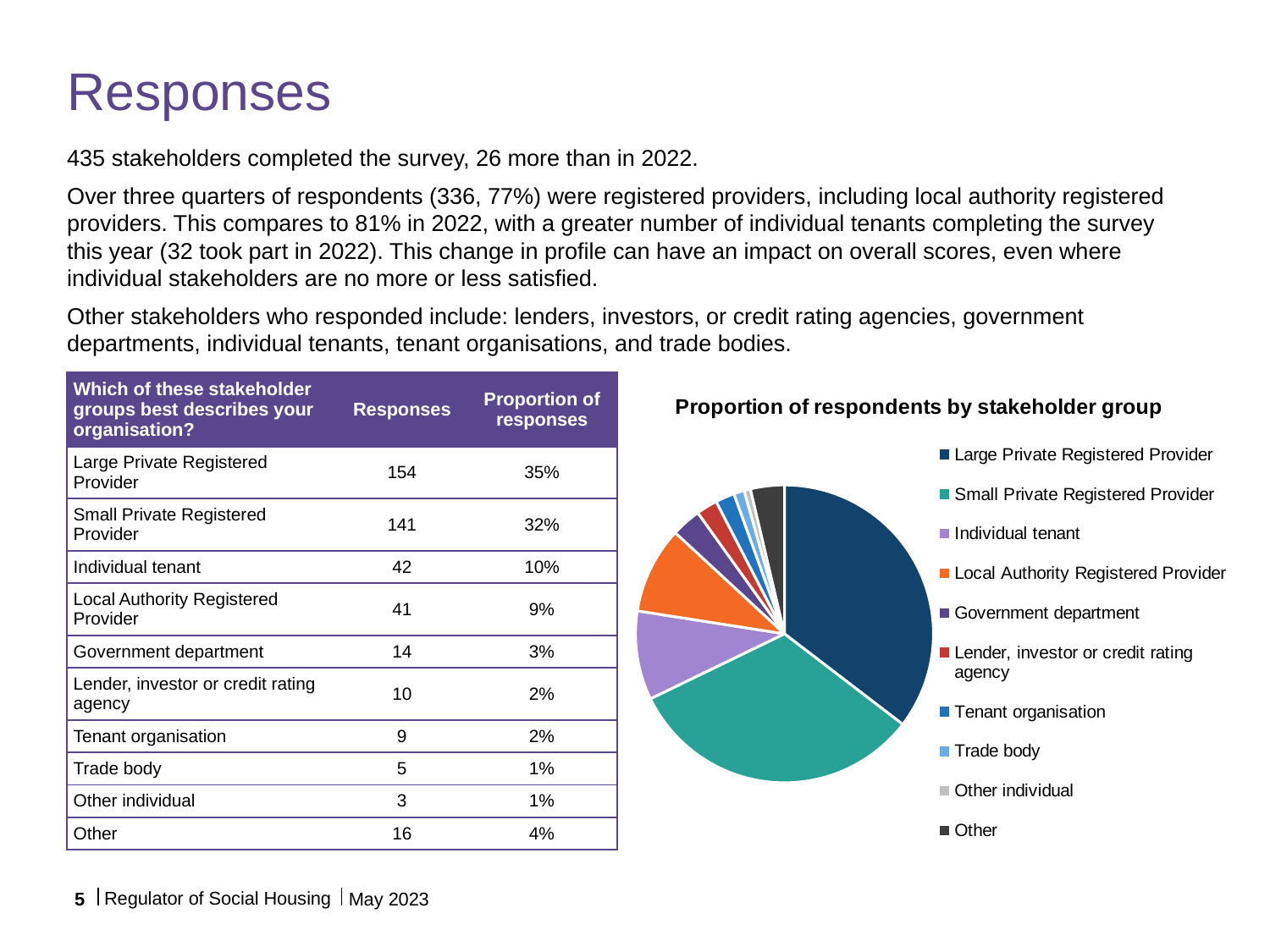
Which stakeholder group has the largest slice of the pie chart? Large Private Registered Provider Which stakeholder group has the smallest slice of the pie chart? Other individual How many stakeholder groups does the legend of the pie chart list? 10 What kind of chart is shown on the slide? pie chart Is the Small Private Registered Provider slice greater or less than 25% of the pie? greater What share of the pie does the Large Private Registered Provider slice represent? 35% What share of the pie does the Individual tenant slice represent? 10% What is the title of the chart? Proportion of respondents by stakeholder group Which slice is larger in the pie chart: Small Private Registered Provider or Local Authority Registered Provider? Small Private Registered Provider Which stakeholder group is shown in orange in the pie chart? Local Authority Registered Provider Which slice is larger in the pie chart: Individual tenant or Government department? Individual tenant What share of the pie does the Other slice represent? 4%